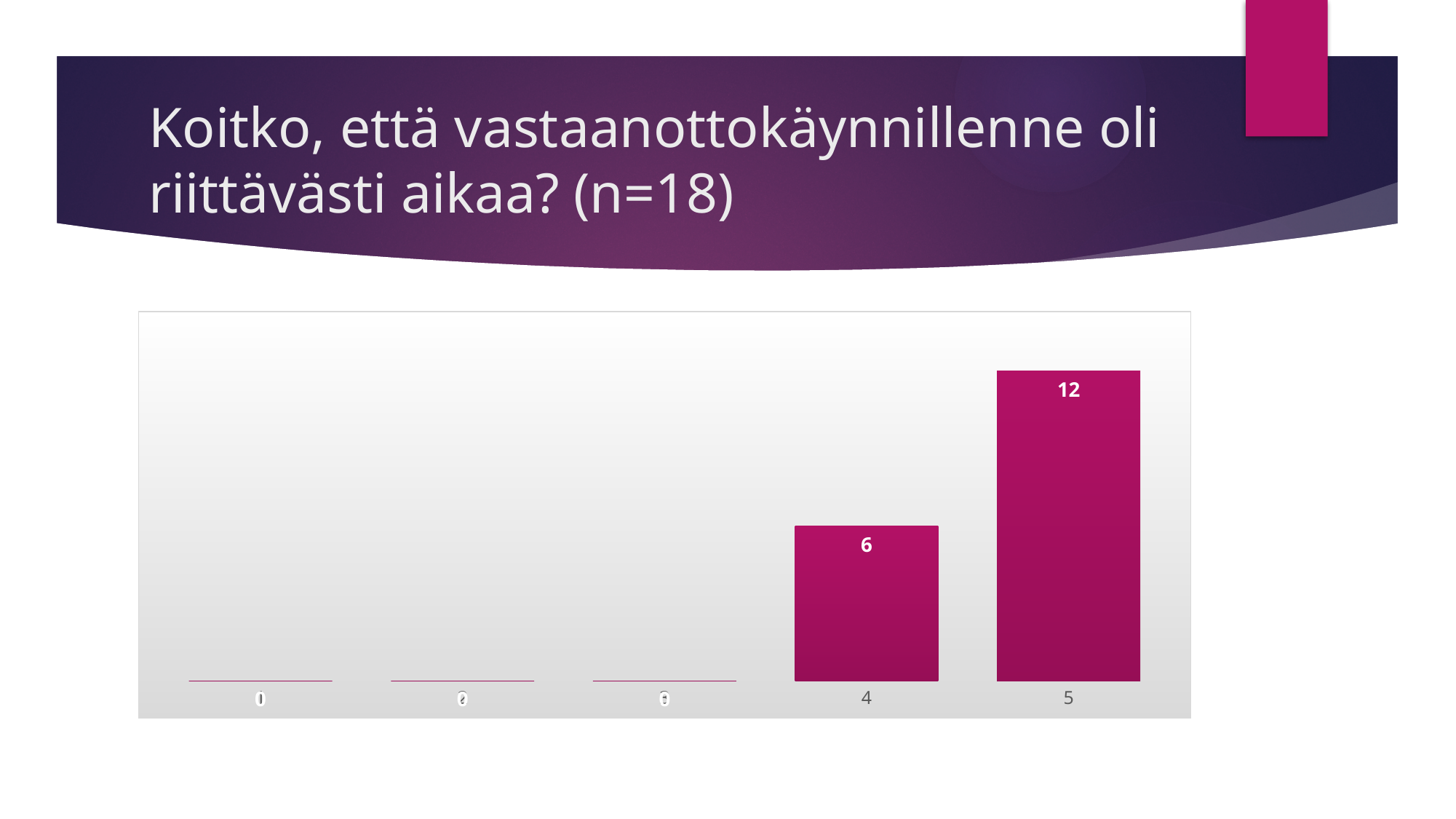
Do the values rise or fall from category 4 to category 5? rise What is the value for category 5? 12 Which is larger, the value for category 4 or the value for category 5? category 5 Which category has the highest value? 5 What is the title of the slide containing the chart? Koitko, että vastaanottokäynnillenne oli riittävästi aikaa? (n=18) What is the value for category 4? 6 What is the difference between the values for category 5 and category 4? 6 What colour are the bars in the chart? magenta How many categories are shown on the x axis? 5 What kind of chart is shown on the slide? bar chart